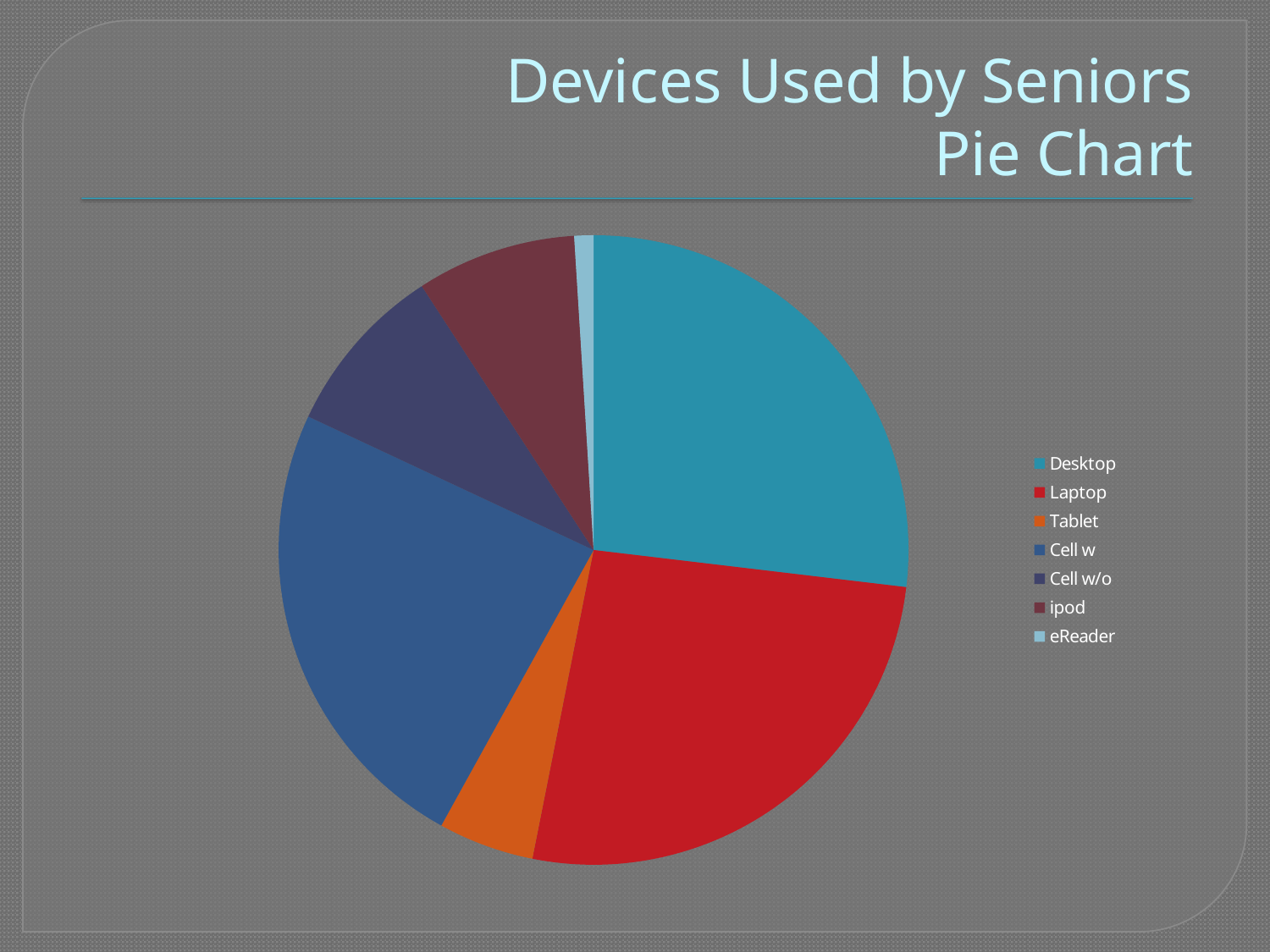
How many categories does the pie chart show? 7 Which slice is larger, Cell w or Tablet? Cell w Which slice is larger, Laptop or Cell w/o? Laptop Which slice is larger, Tablet or ipod? ipod Which category has the smallest slice of the pie? eReader What colour is the Laptop slice in the pie chart? red What kind of chart is shown on the slide? pie chart What is the title of the slide? Devices Used by Seniors Pie Chart